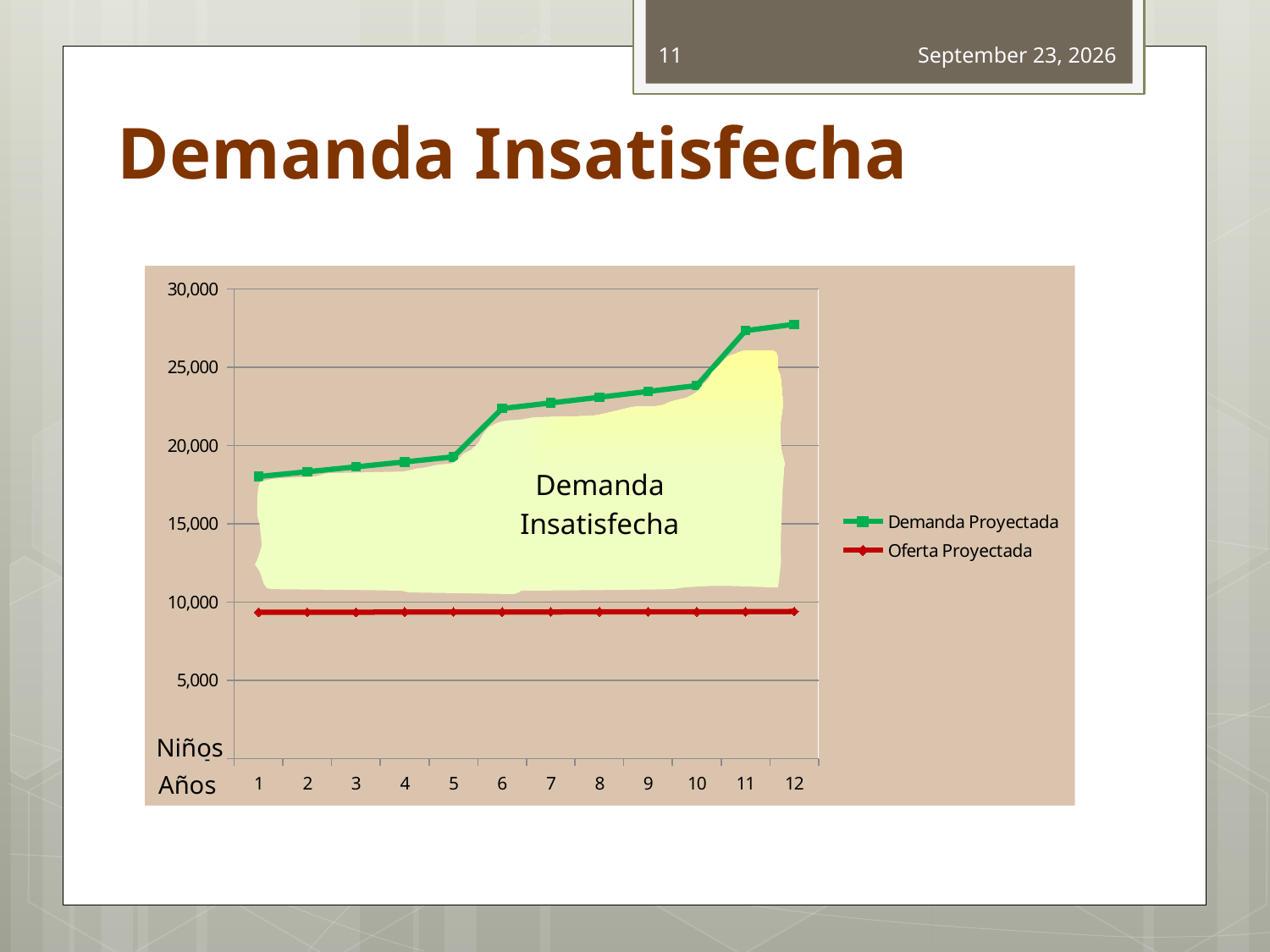
Is the Demanda Proyectada value for year 1 greater or less than 15,000? greater What label is written inside the shaded area between the two lines? Demanda Insatisfecha Is the Oferta Proyectada value for year 5 greater or less than 10,000? less Does Demanda Proyectada rise or fall from year 1 to year 12? rise In which year is Demanda Proyectada lowest? 1 How many years are shown along the x axis? 12 Is the Demanda Proyectada value for year 12 greater or less than 25,000? greater Which series has the larger value in year 8, Demanda Proyectada or Oferta Proyectada? Demanda Proyectada What kind of chart is shown on the slide? line chart How many series does the legend list? 2